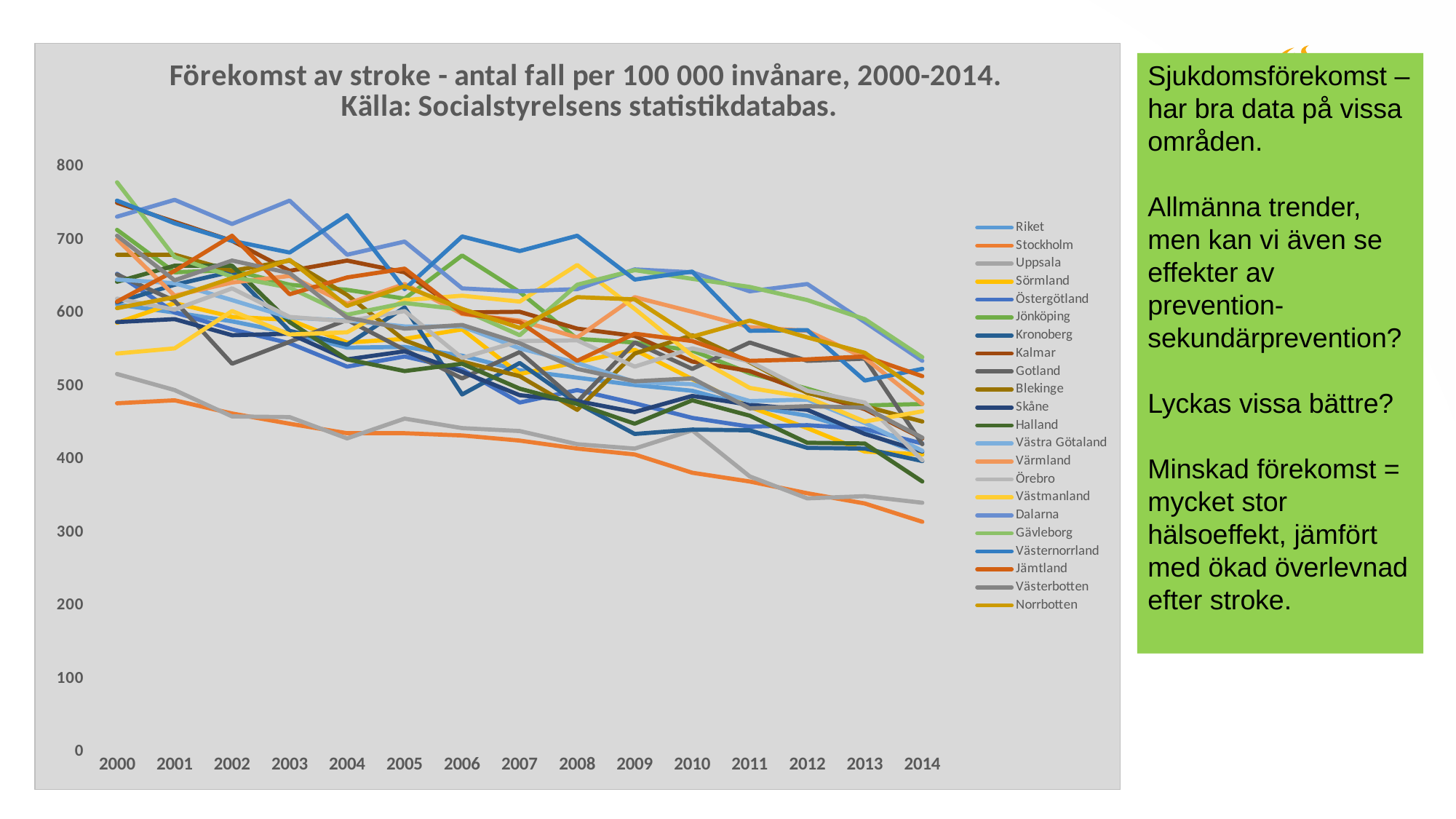
How many series does the legend list? 22 Which is larger in 2014, the value for Stockholm or the value for Uppsala? Uppsala Is the value for Stockholm in 2014 greater or less than 400? less What is the first year shown on the x axis? 2000 Is the value for Uppsala in 2014 greater or less than 400? less Do the stroke incidence values generally rise or fall from 2000 to 2014? fall Is the value for Stockholm in 2000 greater or less than 500? less What kind of chart is shown on the slide? line chart How many years are shown along the x axis? 15 Which series has the lowest value in 2014? Stockholm What is the last year shown on the x axis? 2014